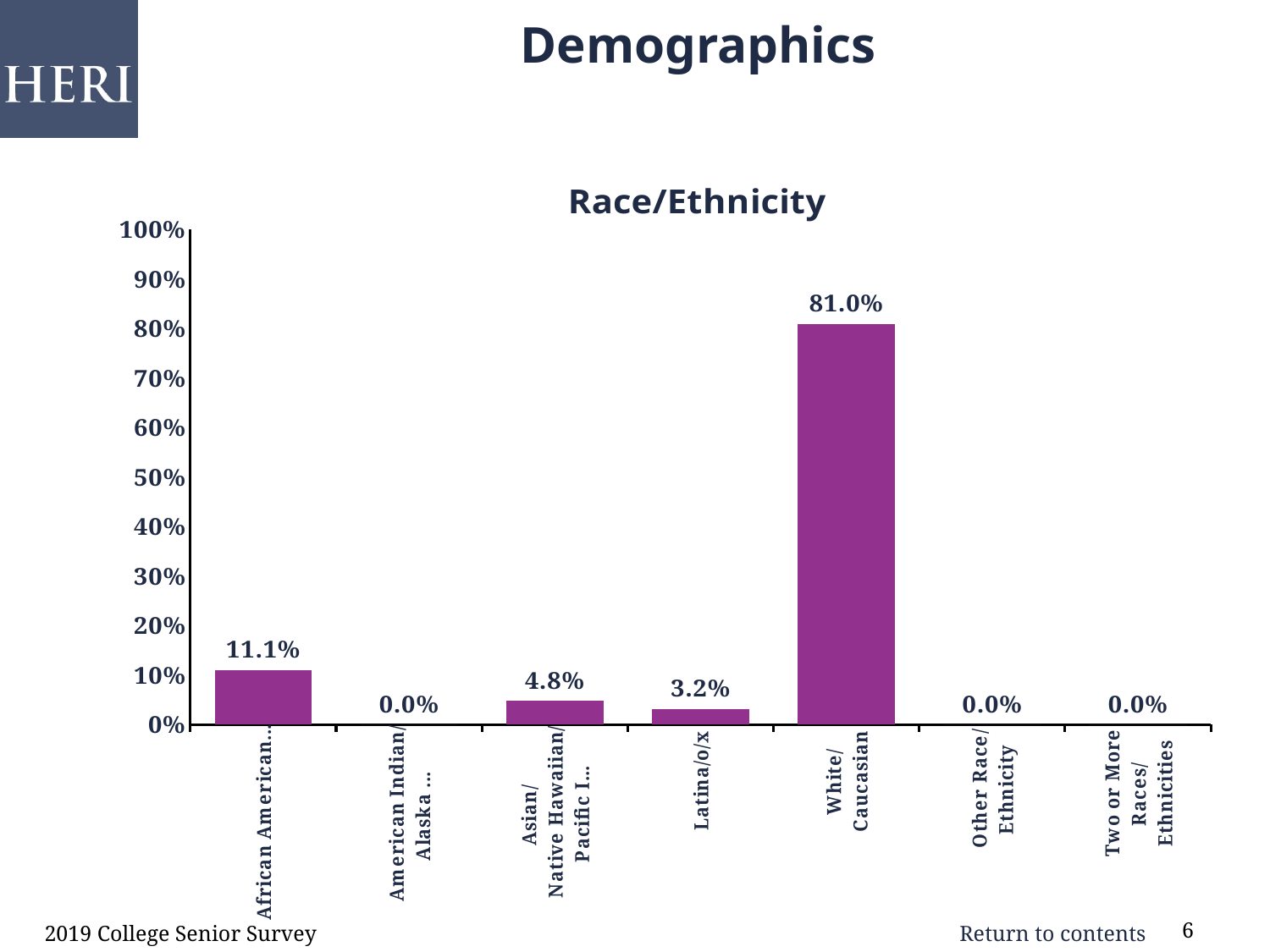
What is the value for White/Caucasian? 81.0% What is the value for Other Race/Ethnicity? 0.0% How many categories have a value of 0.0%? 3 Which is larger, the value for Asian/Native Hawaiian/Pacific Islander or the value for Latina/o/x? Asian/Native Hawaiian/Pacific Islander What is the difference between the values for White/Caucasian and African American? 69.9% How many race/ethnicity categories are shown in the chart? 7 Which category has the highest value? White/Caucasian What is the value for African American? 11.1% What is the title of the chart? Race/Ethnicity What type of chart is shown on the slide? bar chart What is the value for Latina/o/x? 3.2% What is the value for Two or More Races/Ethnicities? 0.0%